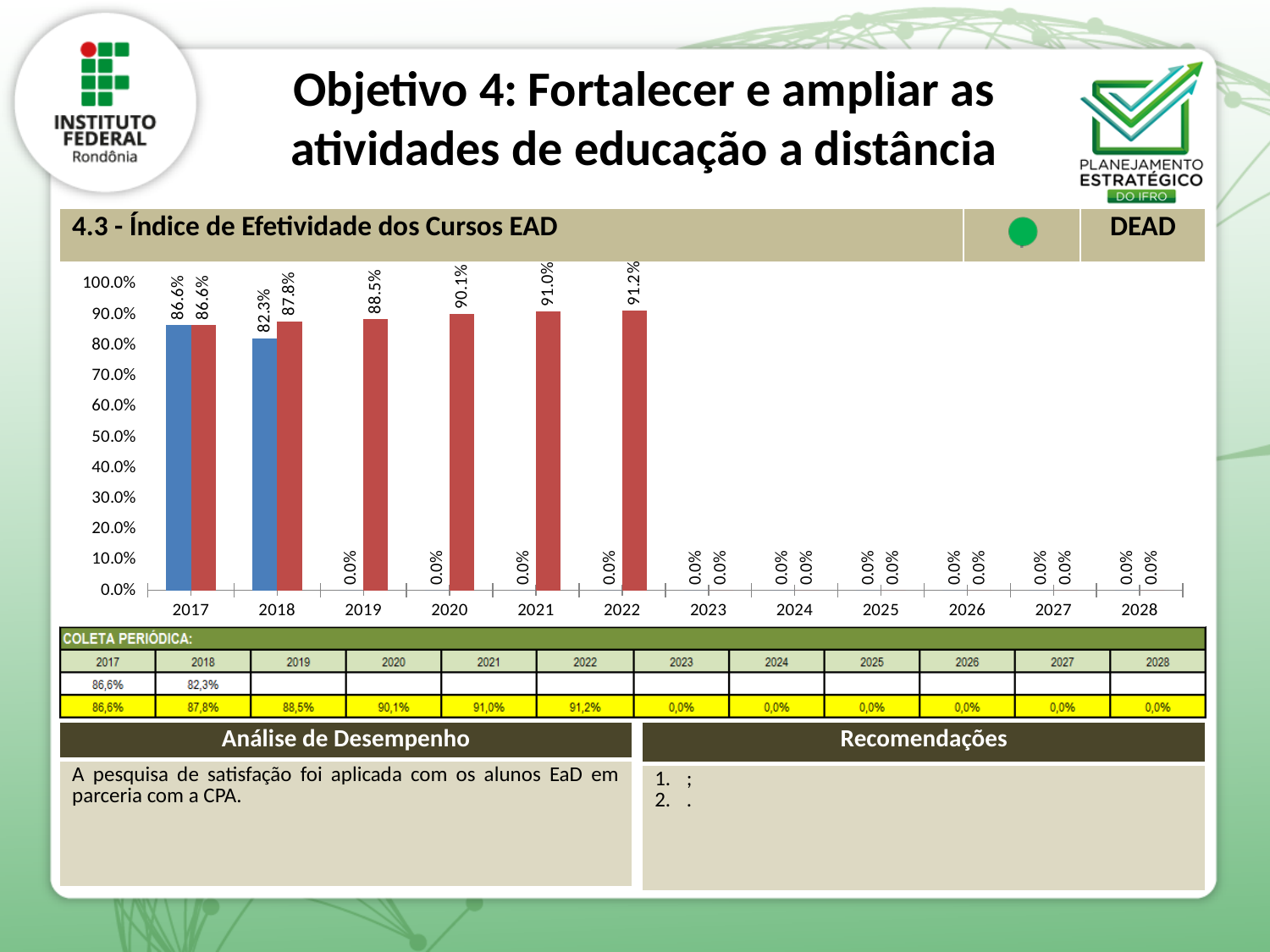
What is the value of the red bar for 2020? 90.1% In which year does the red series reach its highest value? 2022 Is the value of the red bar for 2019 greater or less than 90.0%? less What is the title of the indicator shown above the chart? 4.3 - Índice de Efetividade dos Cursos EAD What kind of chart is shown on the slide? bar chart What is the difference between the red bar and the blue bar for 2018? 5.5% Do the red bars rise or fall from 2017 to 2022? rise For 2018, which bar is larger, the blue one or the red one? the red one What is the difference between the red bar for 2022 and the red bar for 2017? 4.6% How many years are shown on the x axis of the chart? 12 What is the value of the red bar for 2021? 91.0% What is the value of the blue bar for 2018? 82.3%